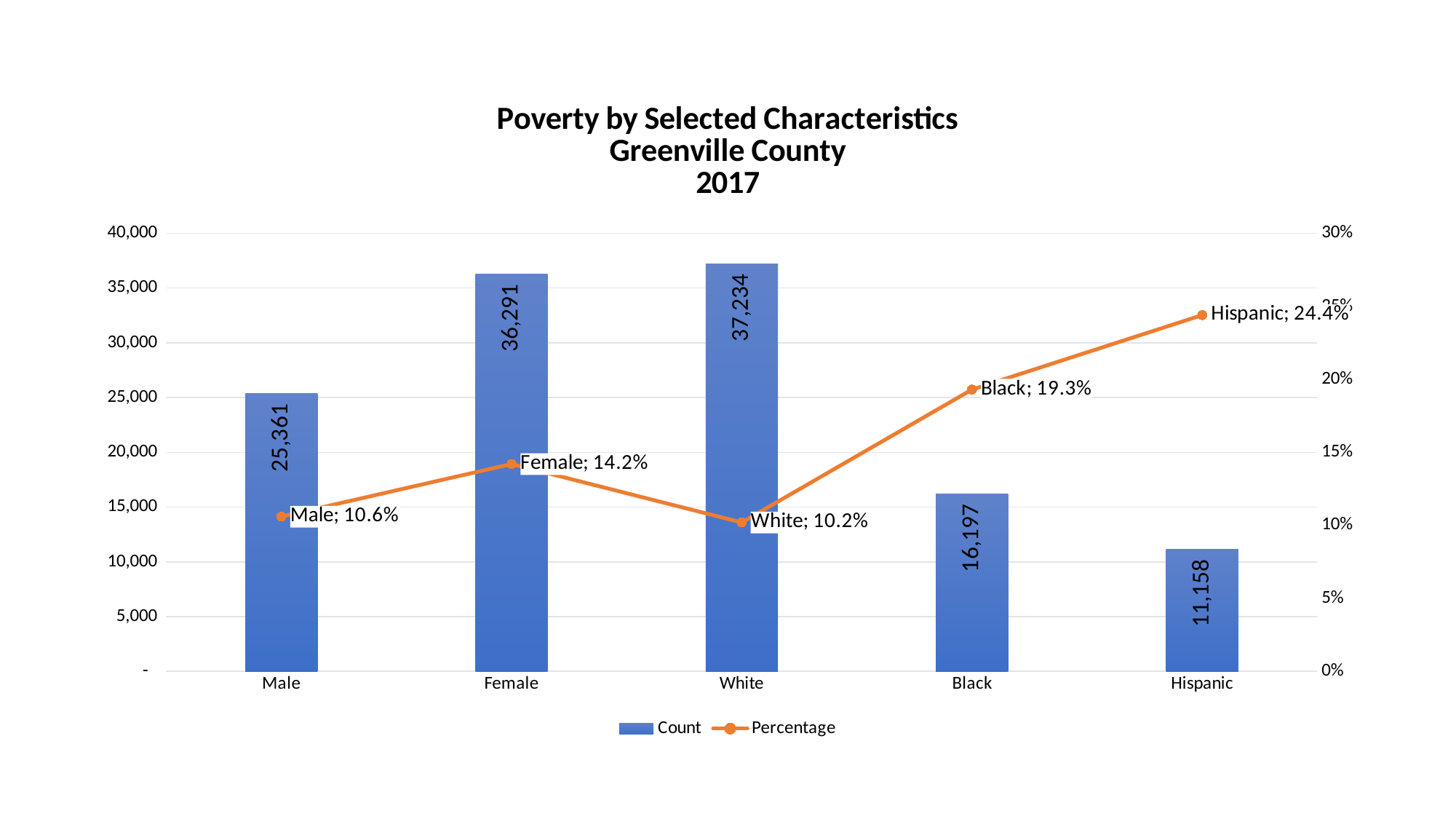
What is the difference between the Percentage for Hispanic and the Percentage for Male? 13.8% What is the Percentage value for Black? 19.3% What kind of chart is this? Combination bar and line chart What is the difference between the Count for White and the Count for Female? 943 What is the title of the chart? Poverty by Selected Characteristics Greenville County 2017 How many categories are shown on the x axis? 5 What is the Count value for Hispanic? 11,158 How many series does the legend list? 2 Which category has the highest Count? White Which category has the lowest Percentage? White What is the Count value for Female? 36,291 Which is larger, the Count for Male or the Count for Black? Male